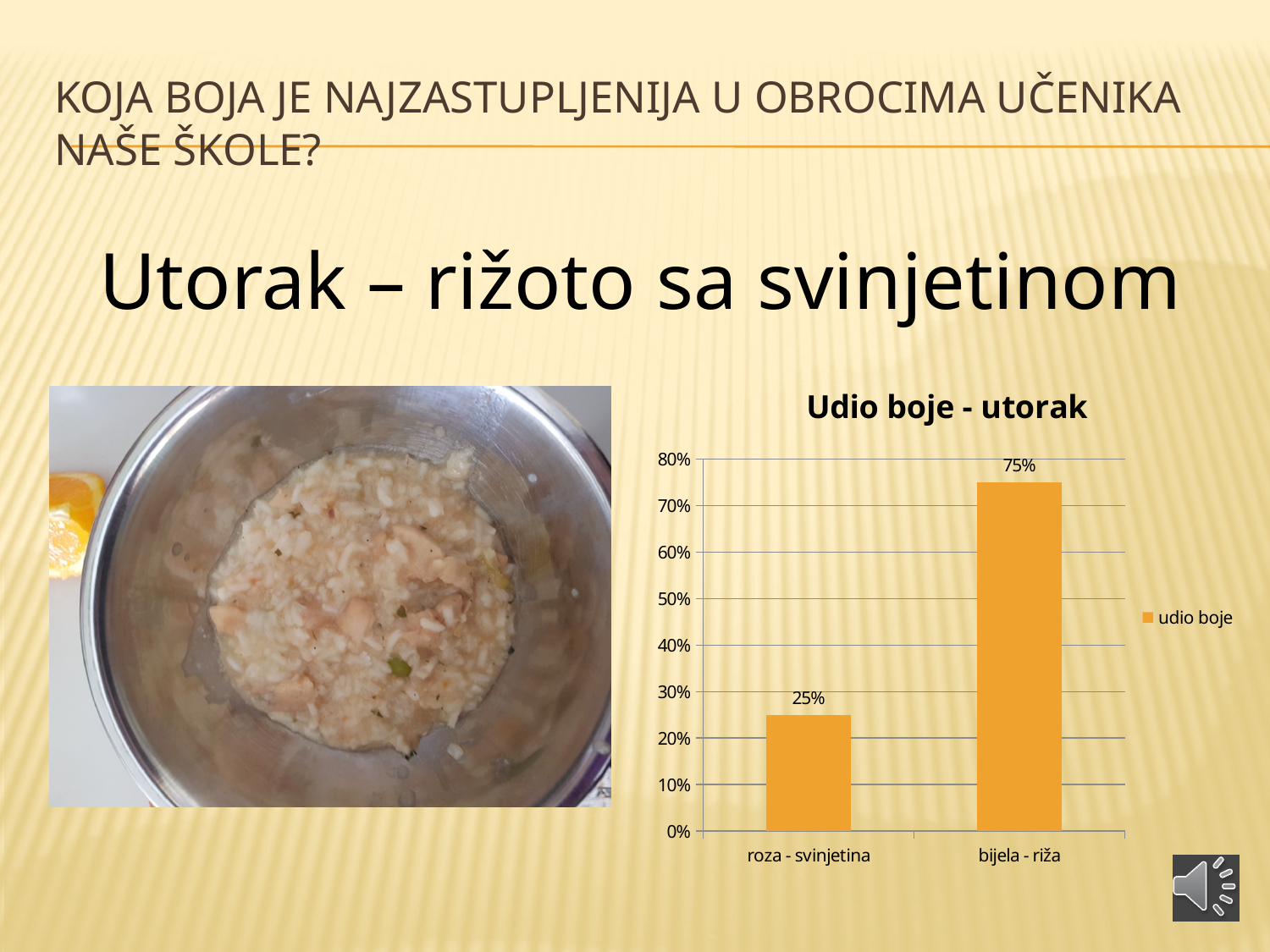
Which category has the highest value? bijela - riža How many series does the legend list? 1 Which category has the lowest value? roza - svinjetina Which is larger, the value for roza - svinjetina or the value for bijela - riža? bijela - riža Is the value for bijela - riža greater or less than 70%? greater What is the value for bijela - riža? 75% Is the value for roza - svinjetina greater or less than 30%? less How many categories are shown on the x axis? 2 What is the value for roza - svinjetina? 25% What is the difference between the values for bijela - riža and roza - svinjetina? 50% What is the title of the chart? Udio boje - utorak What kind of chart is shown on the slide? bar chart